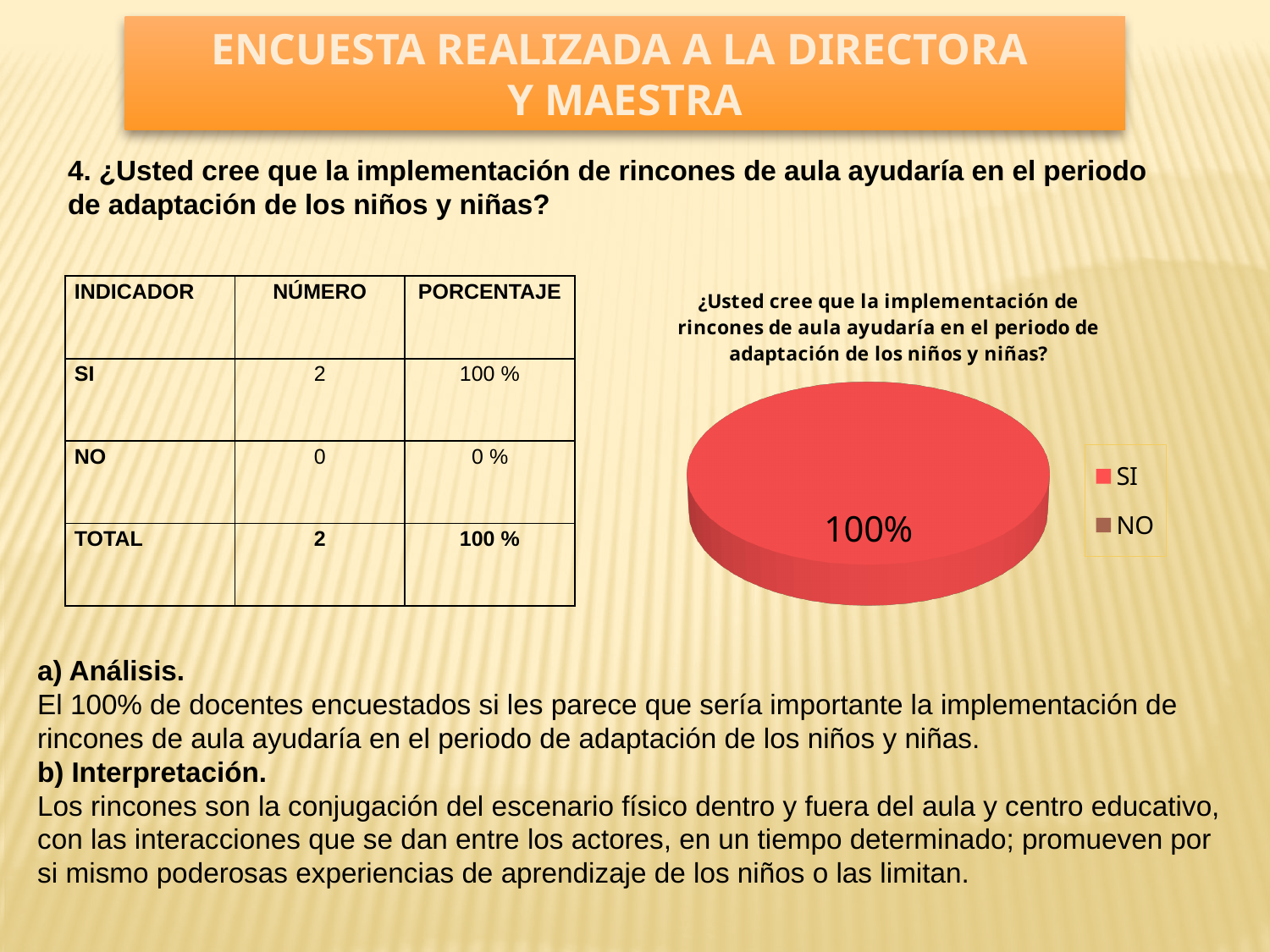
Which category has the smallest share in the pie chart? NO What are the two legend entries of the pie chart? SI and NO What share of the pie chart does the SI slice represent? 100% Which is larger in the pie chart, the share for SI or the share for NO? SI Which category has the largest share in the pie chart? SI What colour is the SI slice in the pie chart? red What data label is printed on the pie chart? 100% What type of chart is shown on the slide? pie chart How many entries does the pie chart's legend list? 2